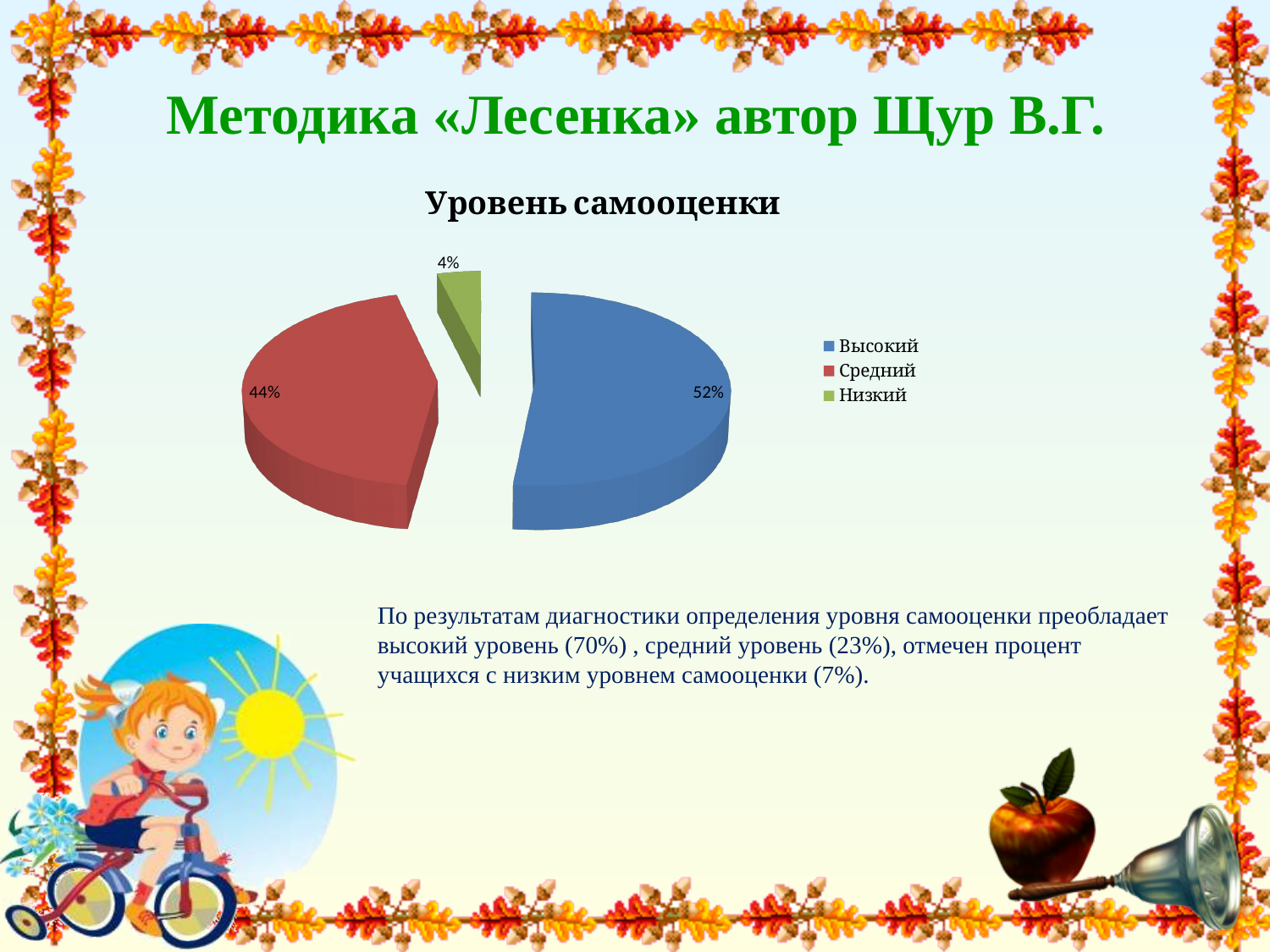
What percentage is shown for Средний? 44% What is the difference in percentage points between Средний and Низкий? 40 What percentage is shown for Низкий? 4% What type of chart is shown on the slide? pie chart Which is larger, the share for Высокий or the share for Средний? Высокий What is the difference in percentage points between Высокий and Средний? 8 What colour is the slice for Низкий? green Which category has the smallest share of the pie? Низкий Which category has the largest share of the pie? Высокий What percentage is shown for Высокий? 52% What is the title of the chart? Уровень самооценки How many categories does the legend list? 3